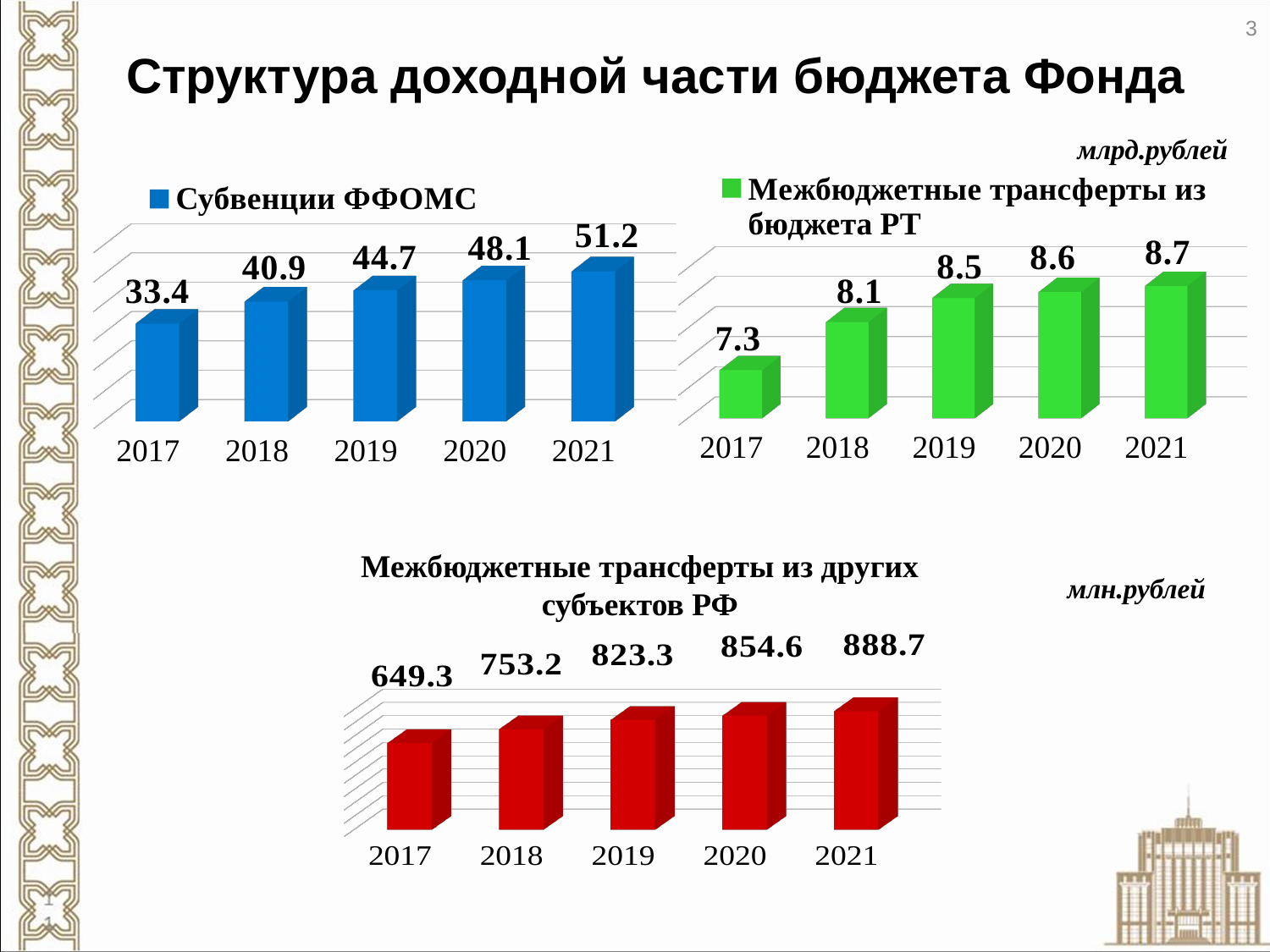
How many years are shown in the 'Субвенции ФФОМС' chart? 5 In the 'Межбюджетные трансферты из других субъектов РФ' chart, what is the value for 2020? 854.6 In the 'Межбюджетные трансферты из других субъектов РФ' chart, what is the difference between the 2018 and 2017 values? 103.9 What type of chart is the 'Межбюджетные трансферты из других субъектов РФ' chart? bar chart In the 'Межбюджетные трансферты из бюджета РТ' chart, which year has the lowest value? 2017 In the 'Субвенции ФФОМС' chart, what is the value for 2019? 44.7 In the 'Межбюджетные трансферты из бюджета РТ' chart, what is the value for 2018? 8.1 In the 'Межбюджетные трансферты из бюджета РТ' chart, do the values rise or fall from 2017 to 2021? rise What colour are the bars in the 'Межбюджетные трансферты из бюджета РТ' chart? green In the 'Субвенции ФФОМС' chart, which year has the highest value? 2021 In the 'Межбюджетные трансферты из других субъектов РФ' chart, which is larger, the value for 2019 or the value for 2021? 2021 In the 'Субвенции ФФОМС' chart, what is the difference between the 2021 and 2017 values? 17.8